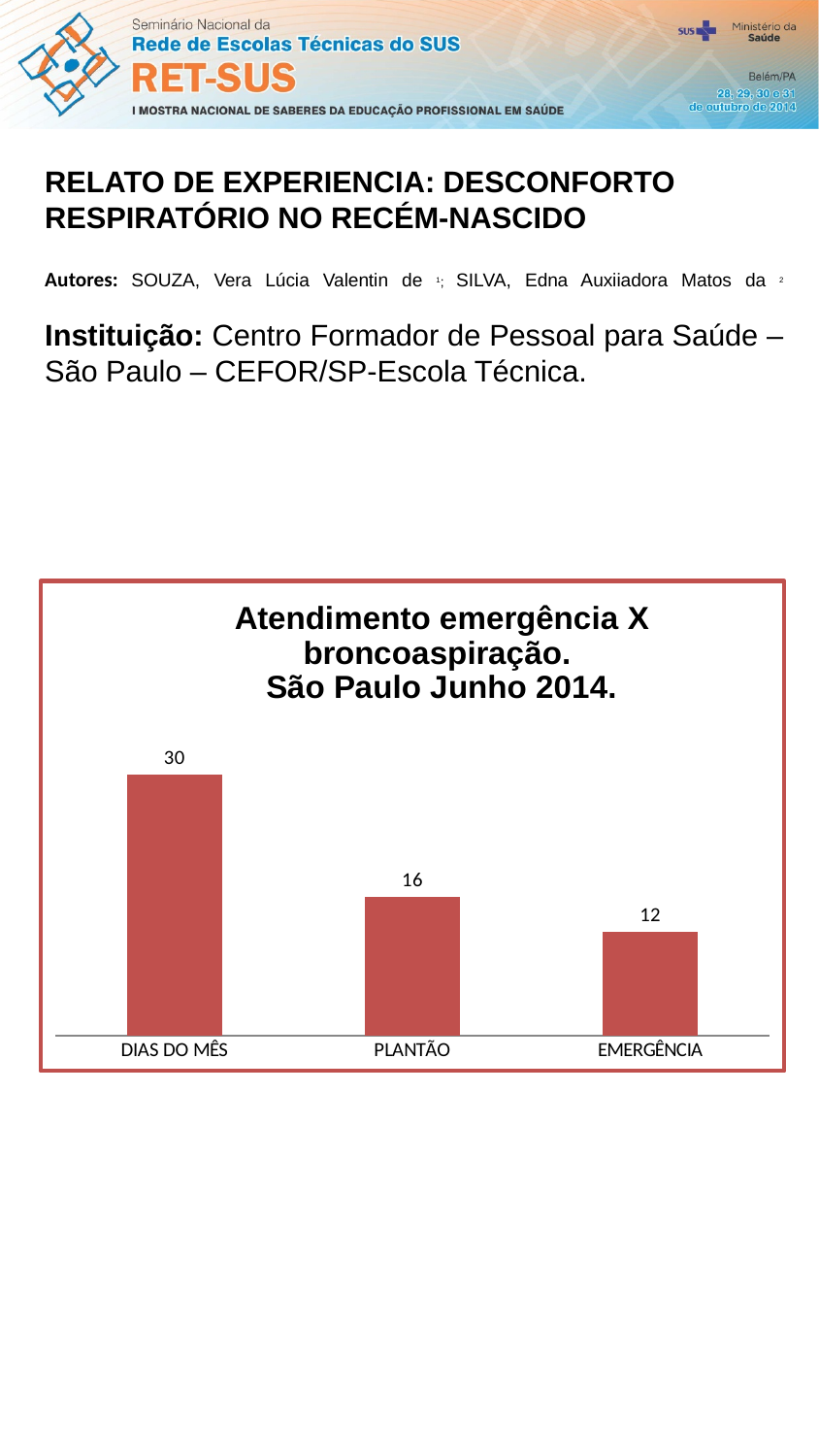
Which category has the highest value? DIAS DO MÊS What is the value for PLANTÃO? 16 Which is larger, the value for PLANTÃO or the value for EMERGÊNCIA? PLANTÃO What is the value for DIAS DO MÊS? 30 Do the values rise or fall from left to right across the categories? fall What is the difference between the values for PLANTÃO and EMERGÊNCIA? 4 What is the title of the chart? Atendimento emergência X broncoaspiração. São Paulo Junho 2014. What kind of chart is shown on the slide? bar chart What is the difference between the values for DIAS DO MÊS and PLANTÃO? 14 What is the value for EMERGÊNCIA? 12 How many categories are shown in the chart? 3 Which category has the lowest value? EMERGÊNCIA